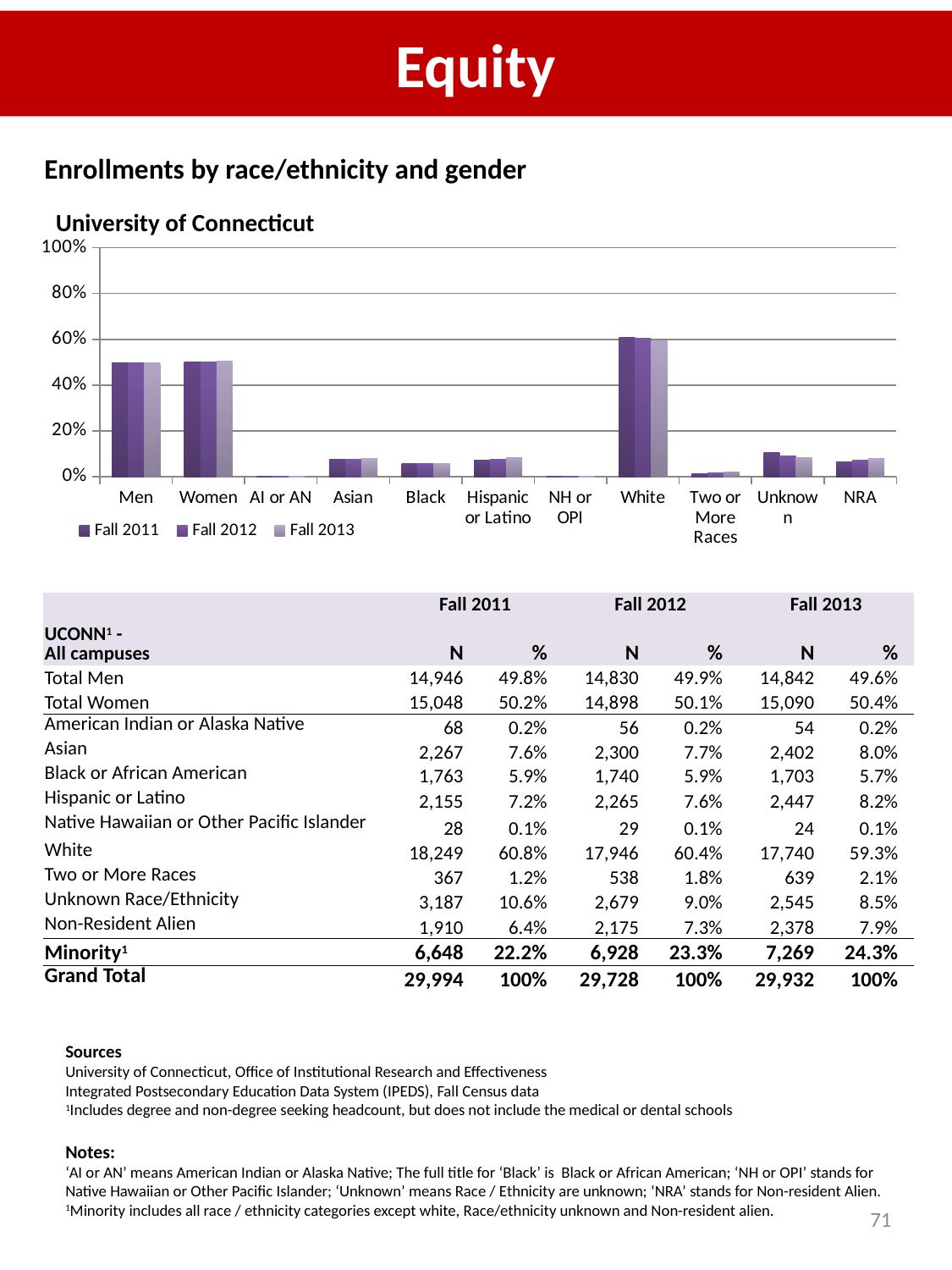
Is the Fall 2011 value for White greater or less than 40%? greater How many categories are shown along the x axis of the chart? 11 Which is larger in Fall 2012: the value for White or the value for Asian? White What kind of chart is shown on the slide? bar chart What are the three series listed in the chart legend? Fall 2011, Fall 2012, Fall 2013 Which is larger in Fall 2011: the value for Unknown or the value for NRA? Unknown Is the Fall 2011 value for Unknown greater or less than 20%? less Do the bars for Unknown rise or fall from Fall 2011 to Fall 2013? fall Which race/ethnicity category has the highest bars in the chart? White Is the Fall 2013 value for Men greater or less than 40%? greater How many series does the chart legend list? 3 What is the title of the chart? University of Connecticut